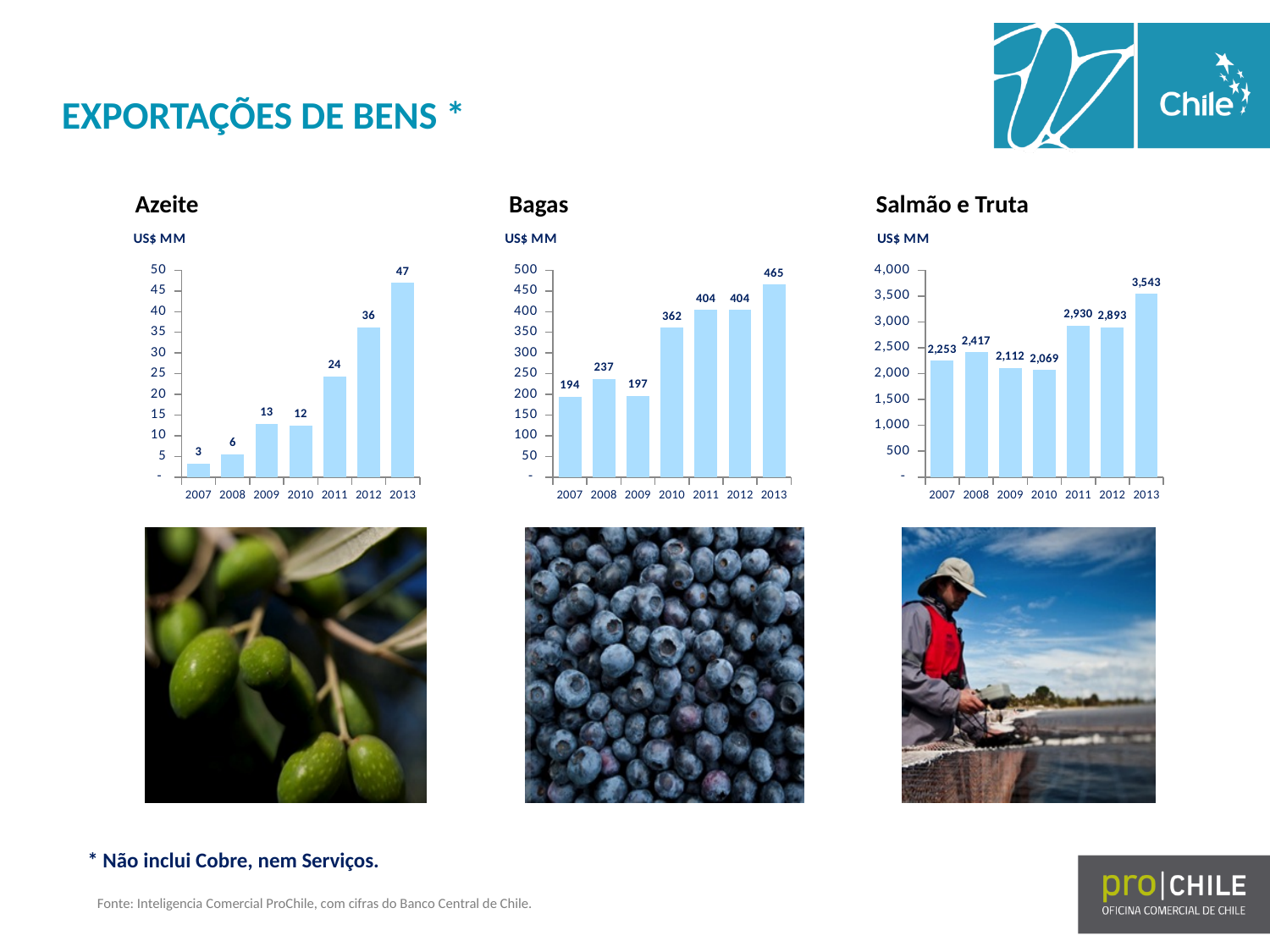
In the Azeite chart, what is the difference between the values for 2013 and 2012? 11 In the Salmão e Truta chart, which year has the lowest value? 2010 In the Salmão e Truta chart, what is the value for 2011? 2,930 What kind of chart is the Salmão e Truta chart? bar chart What unit is shown above each of the three charts? US$ MM In the Azeite chart, what is the value for 2013? 47 In the Bagas chart, what is the difference between the values for 2008 and 2007? 43 How many years are shown in the Bagas chart? 7 In the Azeite chart, which year has the lowest value? 2007 In the Salmão e Truta chart, which is larger, the value for 2008 or the value for 2009? 2008 In the Bagas chart, which year has the highest value? 2013 In the Bagas chart, what is the value for 2010? 362